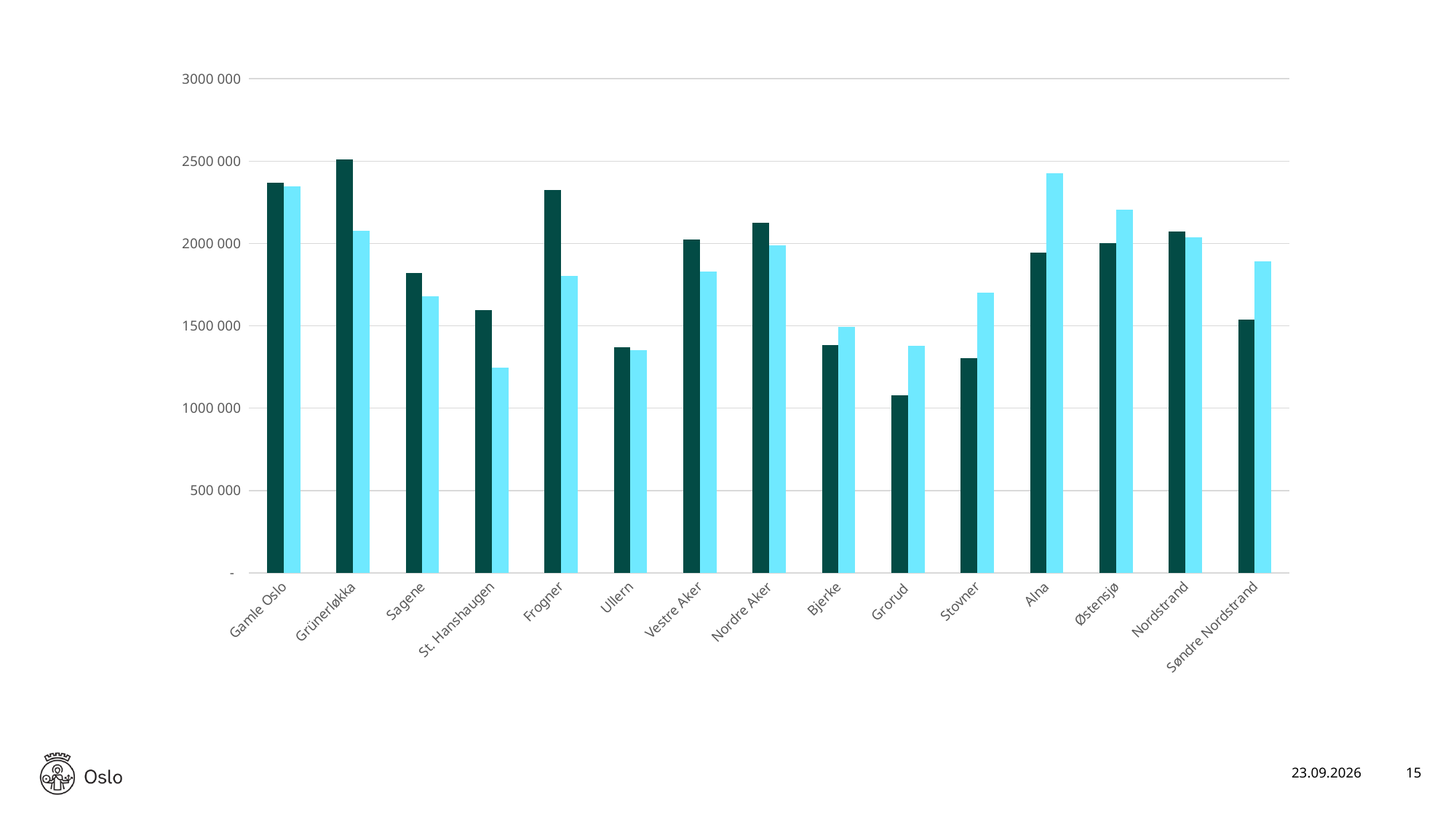
Which district has the shortest dark green bar? Grorud Is the dark green bar for Frogner greater or less than 2000 000? greater How many bars are shown for each district? 2 Is the light blue bar for Alna greater or less than 2000 000? greater Which district has the tallest light blue bar? Alna Which district has the tallest dark green bar? Grünerløkka Which district has the shortest light blue bar? St. Hanshaugen Is the dark green bar for Grorud greater or less than 1500 000? less What kind of chart is shown on the slide? bar chart For Grünerløkka, which bar is taller, the dark green one or the light blue one? the dark green one How many districts (categories) are shown along the x axis? 15 For Stovner, which bar is taller, the dark green one or the light blue one? the light blue one